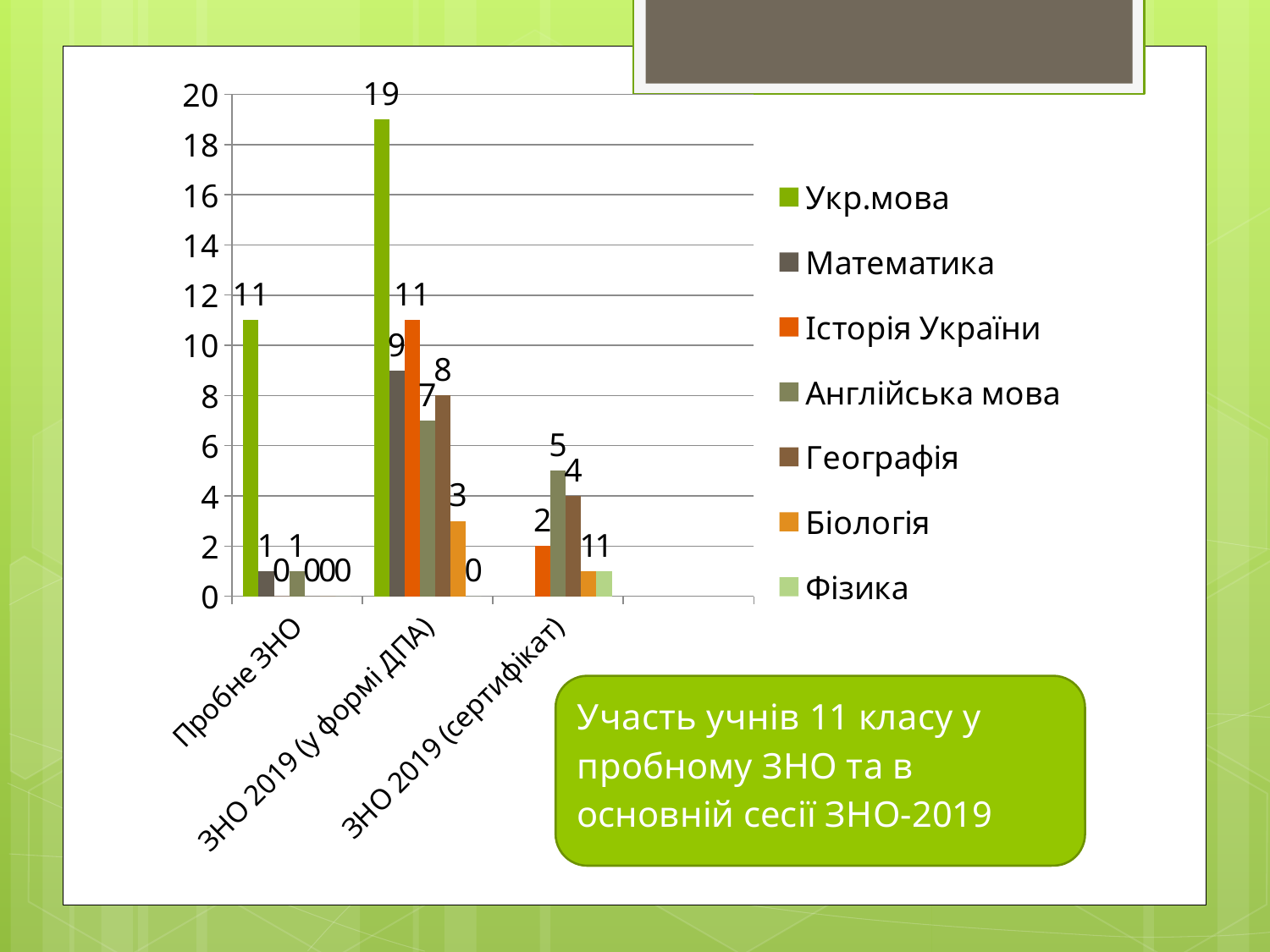
What is the value for Біологія in the ЗНО 2019 (у формі ДПА) category? 3 How many categories are shown on the x axis? 3 How many series does the legend list? 7 What is the value for Англійська мова in the ЗНО 2019 (сертифікат) category? 5 What is the value for Укр.мова in the ЗНО 2019 (у формі ДПА) category? 19 What kind of chart is shown on the slide? bar chart What is the value for Укр.мова in the Пробне ЗНО category? 11 Which series has the highest value in the ЗНО 2019 (сертифікат) category? Англійська мова What is the difference between Укр.мова and Математика in the ЗНО 2019 (у формі ДПА) category? 10 What is the value for Історія України in the ЗНО 2019 (у формі ДПА) category? 11 In the ЗНО 2019 (у формі ДПА) category, which is larger: Географія or Англійська мова? Географія Which series has the highest value in the ЗНО 2019 (у формі ДПА) category? Укр.мова